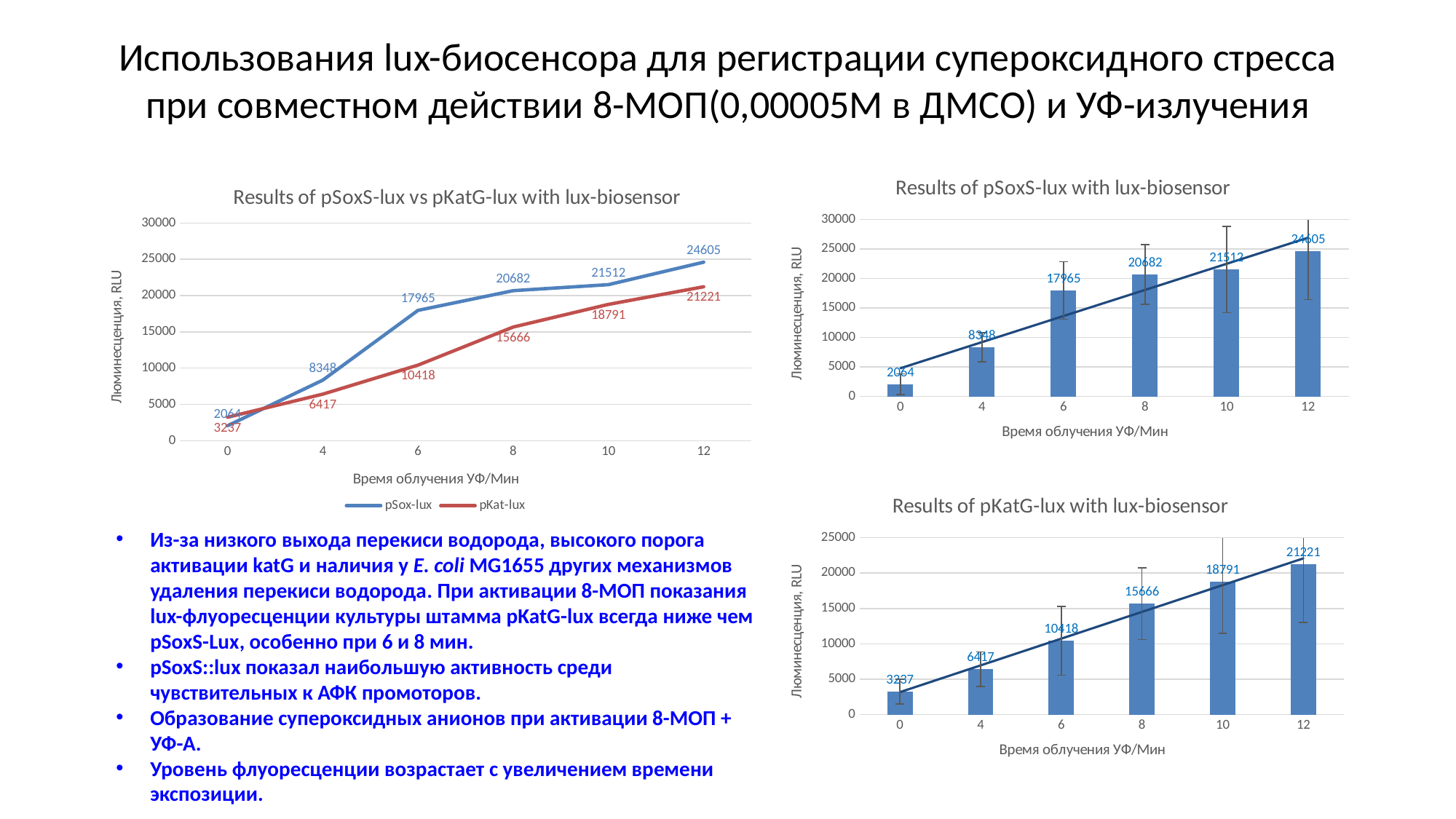
In the chart titled "Results of pSoxS-lux vs pKatG-lux with lux-biosensor", how many series does the legend list? 2 In the chart titled "Results of pSoxS-lux vs pKatG-lux with lux-biosensor", what is the value of pSox-lux at 6 minutes? 17965 In the chart titled "Results of pSoxS-lux vs pKatG-lux with lux-biosensor", which series has the larger value at 0 minutes? pKat-lux What type of chart is the one titled "Results of pSoxS-lux vs pKatG-lux with lux-biosensor"? line chart In the chart titled "Results of pKatG-lux with lux-biosensor", do the values rise or fall as the irradiation time increases? rise What type of chart is the one titled "Results of pKatG-lux with lux-biosensor"? bar chart In the chart titled "Results of pSoxS-lux with lux-biosensor", how many bars are plotted? 6 In the chart titled "Results of pSoxS-lux with lux-biosensor", at which time is the value lowest? 0 In the chart titled "Results of pSoxS-lux vs pKatG-lux with lux-biosensor", what is the value of pKat-lux at 8 minutes? 15666 In the chart titled "Results of pSoxS-lux with lux-biosensor", what is the value at 12 minutes? 24605 In the chart titled "Results of pSoxS-lux vs pKatG-lux with lux-biosensor", what is the difference between pSox-lux and pKat-lux at 6 minutes? 7547 In the chart titled "Results of pKatG-lux with lux-biosensor", what is the value at 10 minutes? 18791